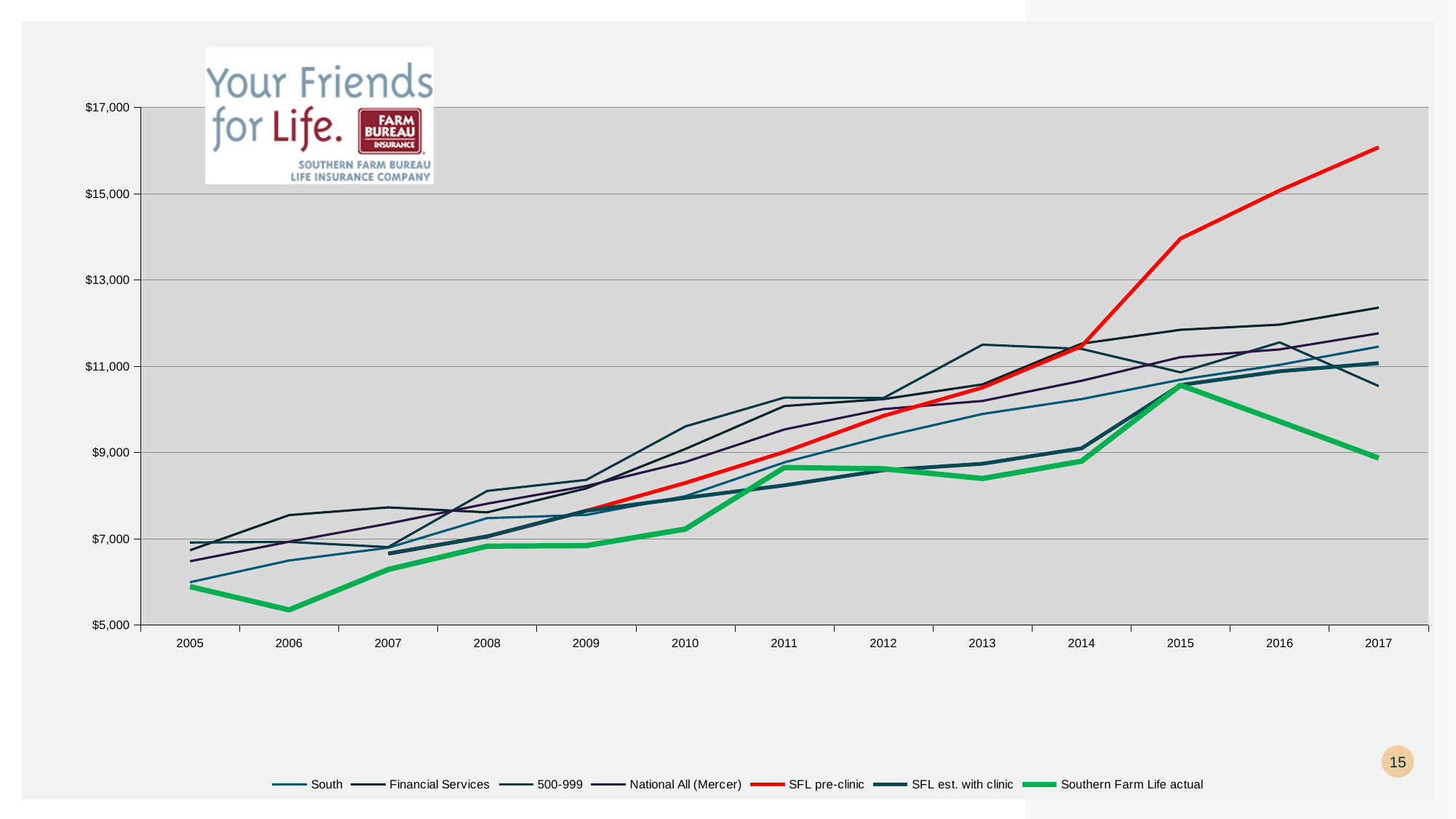
In 2015, which is larger: SFL pre-clinic or Southern Farm Life actual? SFL pre-clinic Which series has the lowest value in 2017? Southern Farm Life actual Is the value for SFL pre-clinic in 2017 greater or less than $15,000? greater Is the value for Southern Farm Life actual in 2015 greater or less than $9,000? greater Does the SFL pre-clinic line rise or fall from 2009 to 2017? rise Does the Southern Farm Life actual line rise or fall from 2015 to 2017? fall How many years are shown along the x axis? 13 Which series has the lowest value in 2006? Southern Farm Life actual How many series does the legend list? 7 Which series has the highest value in 2017? SFL pre-clinic What kind of chart is shown on the slide? line chart Is the value for Southern Farm Life actual in 2006 greater or less than $7,000? less